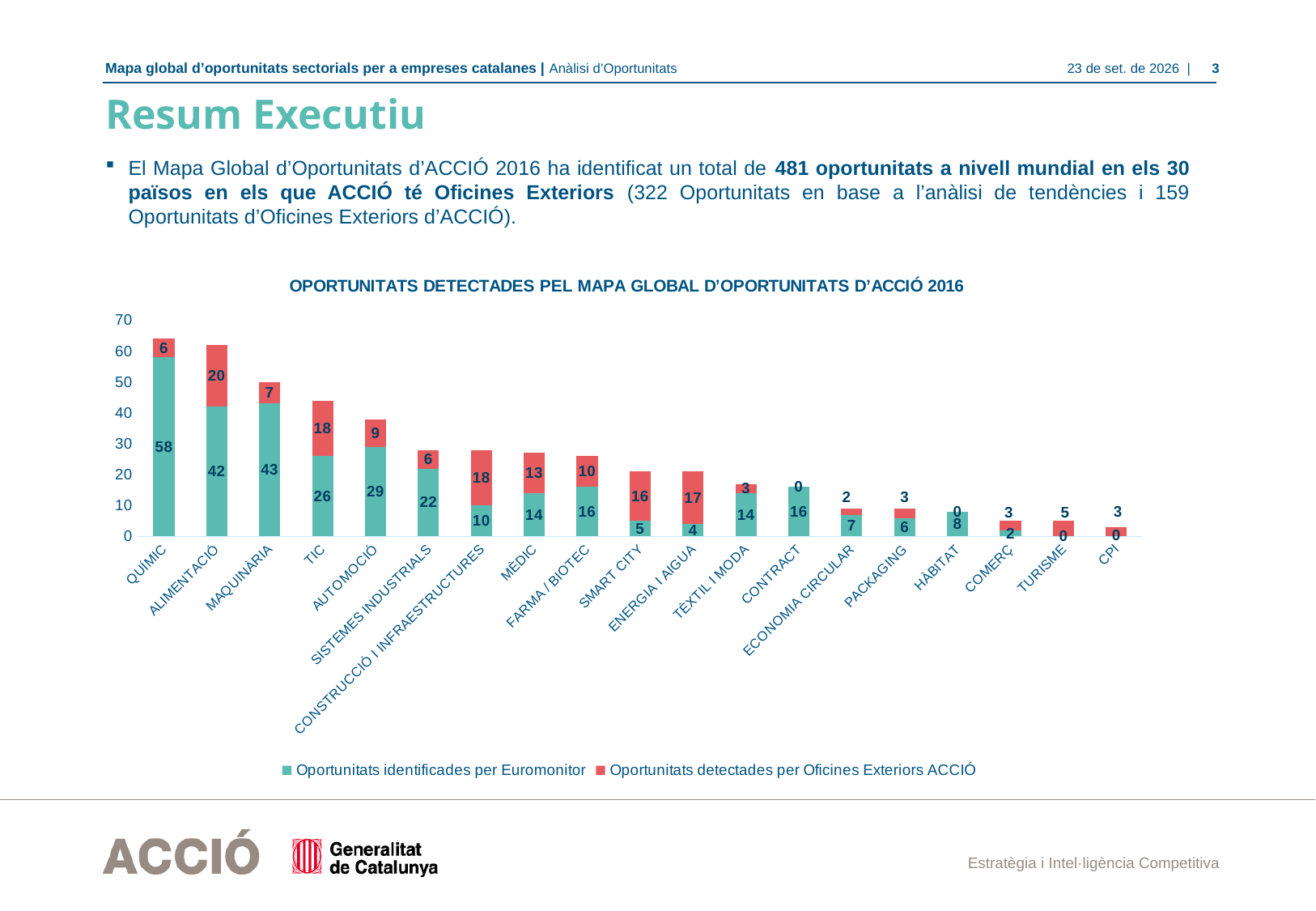
What is the total of the stacked bar for QUÍMIC? 64 What is the value of Oportunitats identificades per Euromonitor for CONSTRUCCIÓ I INFRAESTRUCTURES? 10 Which is larger: the Oficines Exteriors ACCIÓ value for TIC or for AUTOMOCIÓ? TIC Which sector has the highest value for Oportunitats identificades per Euromonitor? QUÍMIC How many series does the legend list? 2 How many sector categories are shown on the x axis? 19 What is the title of the chart? OPORTUNITATS DETECTADES PEL MAPA GLOBAL D'OPORTUNITATS D'ACCIÓ 2016 Which sector has the highest value for Oportunitats detectades per Oficines Exteriors ACCIÓ? ALIMENTACIÓ What is the value of Oportunitats detectades per Oficines Exteriors ACCIÓ for ALIMENTACIÓ? 20 What kind of chart is shown on the slide? Stacked bar chart What is the value of Oportunitats identificades per Euromonitor for QUÍMIC? 58 What is the difference between the Euromonitor values for MAQUINÀRIA and ALIMENTACIÓ? 1